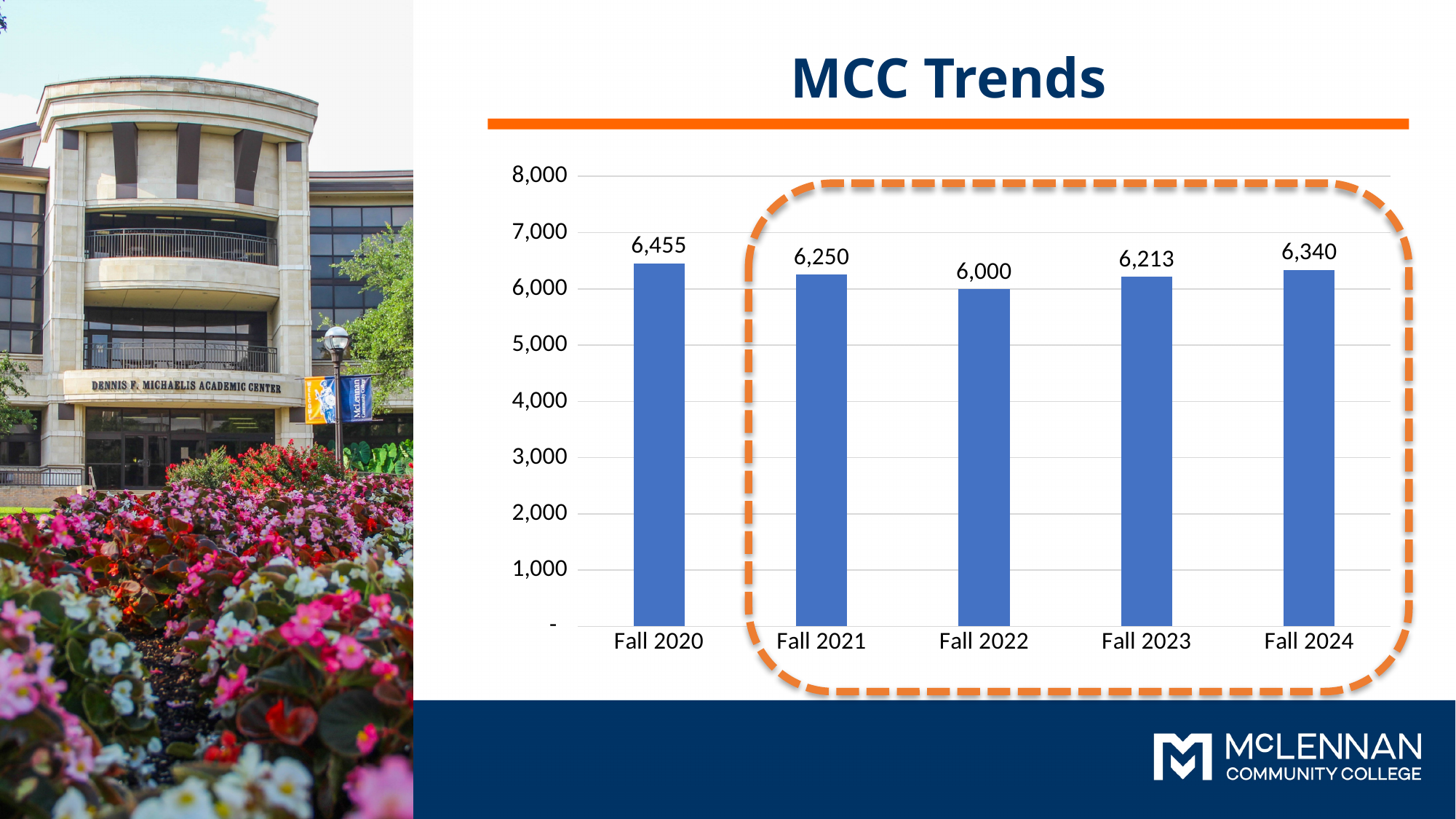
How many categories are shown on the x axis? 5 What is the value for Fall 2020? 6,455 What is the title of the chart? MCC Trends What is the value for Fall 2024? 6,340 Is the value for Fall 2022 greater or less than 7,000? less Which category has the lowest value? Fall 2022 What kind of chart is shown on the slide? bar chart Which is larger, the value for Fall 2021 or the value for Fall 2023? Fall 2021 What is the difference between the Fall 2020 and Fall 2024 values? 115 Which category has the highest value? Fall 2020 What is the value for Fall 2022? 6,000 What is the difference between the Fall 2023 and Fall 2022 values? 213